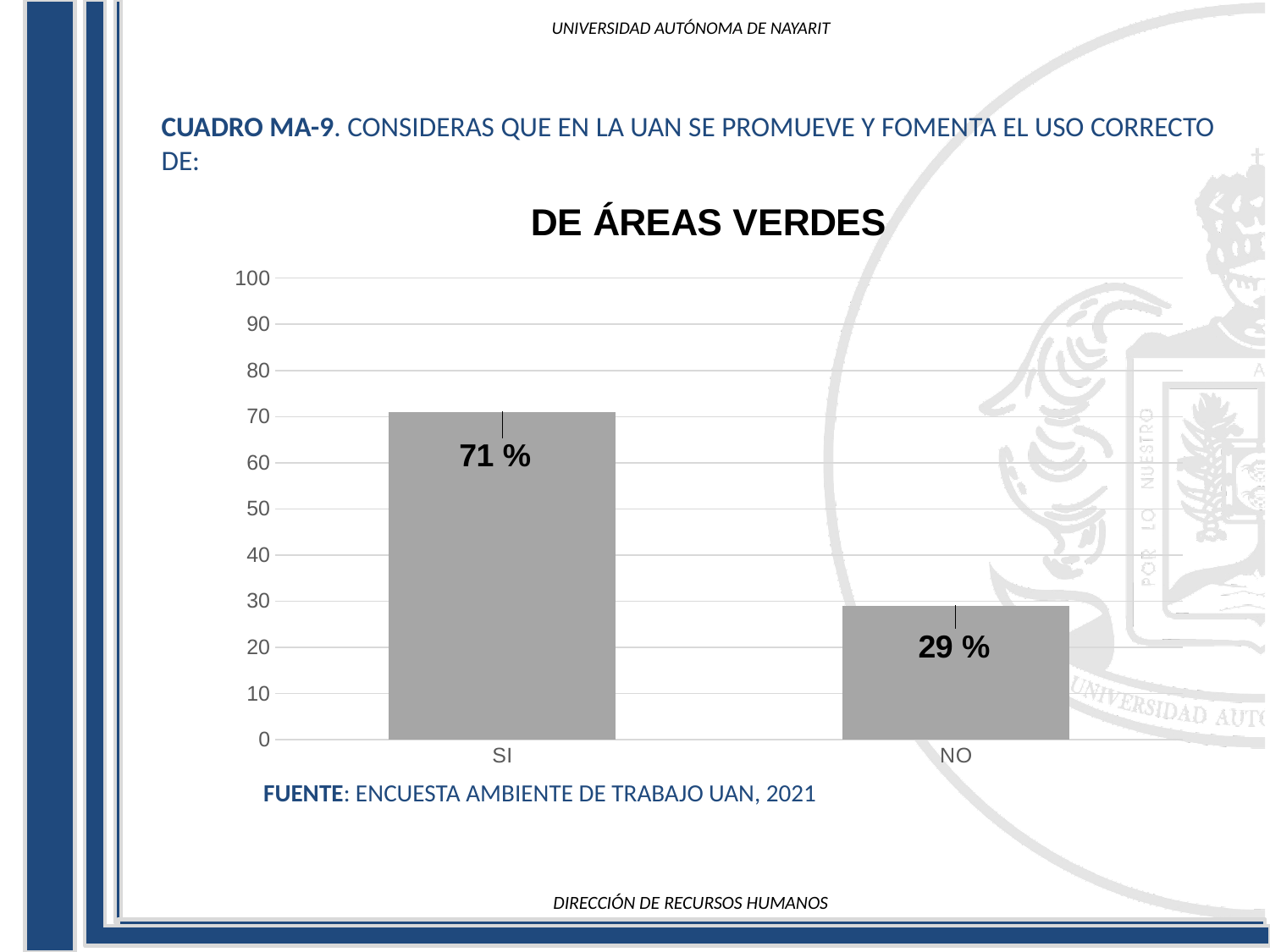
What is the difference between the values for SI and NO? 42 % Is the value for SI greater or less than 60? greater Which category has the highest value? SI What is the value for NO? 29 % Which category has the lowest value? NO How many categories are shown on the x axis? 2 Which is larger, the value for SI or the value for NO? SI What is the maximum value shown on the y axis? 100 What is the value for SI? 71 % What kind of chart is shown? bar chart What is the title of the chart? DE ÁREAS VERDES Is the value for NO greater or less than 30? less